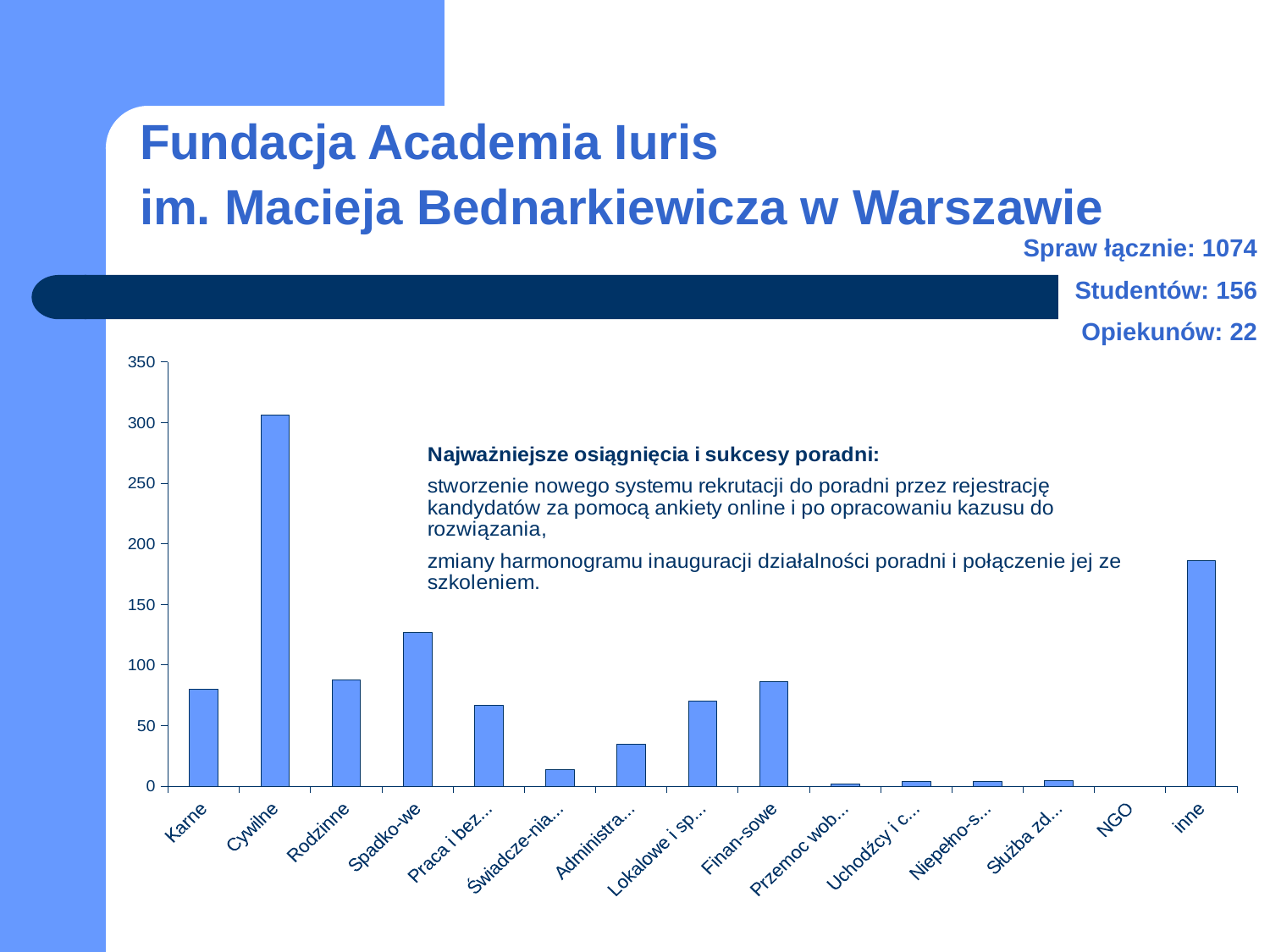
Which category has the highest bar in the chart? Cywilne Which category has the lowest value in the chart? NGO What is the label of the first category on the x axis of the chart? Karne Which is larger, the value for Cywilne or the value for inne? Cywilne Is the value for Karne greater or less than 100? less How many categories are shown on the x axis of the chart? 15 Is the value for Spadko-we greater or less than 100? greater Is the value for inne greater or less than 200? less Which is larger, the value for Spadko-we or the value for Rodzinne? Spadko-we Which is larger, the value for Administra... or the value for Świadcze-nia...? Administra... What kind of chart is shown on the slide? bar chart